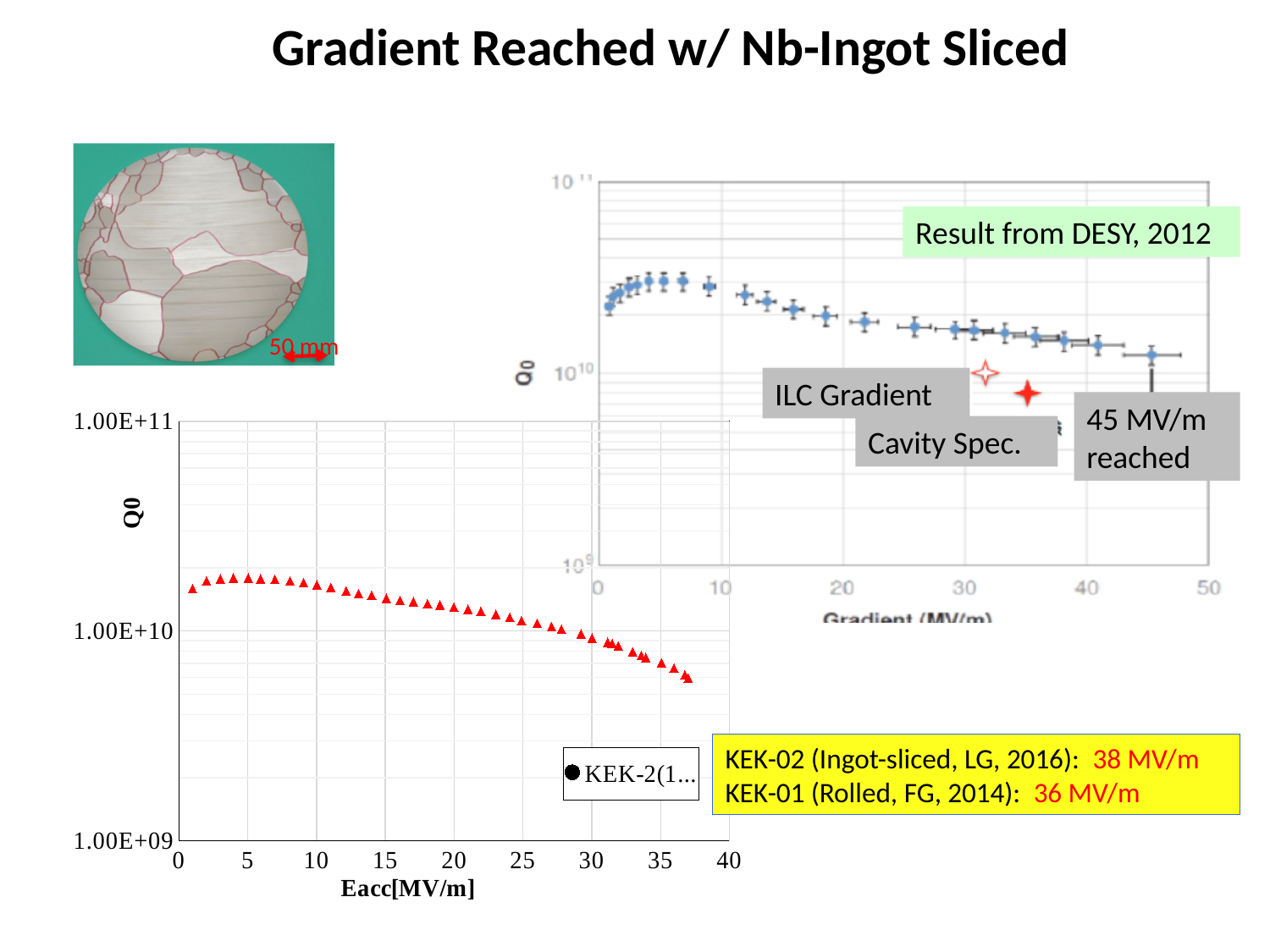
How many series does the legend of the bottom-left chart list? 1 In the top-right chart labelled 'Result from DESY, 2012', is the Q0 value at a gradient of 5 MV/m greater or less than 10^10? greater In the bottom-left chart, which has the larger Q0: the point at Eacc = 5 MV/m or the point at Eacc = 35 MV/m? Eacc = 5 MV/m What is the label of the x axis of the bottom-left chart? Eacc[MV/m] In the bottom-left chart, is the Q0 value at Eacc = 35 MV/m greater or less than 1.00E+10? less In the top-right chart labelled 'Result from DESY, 2012', which has the larger Q0: the point at a gradient of 5 MV/m or the point at 45 MV/m? 5 MV/m In the bottom-left chart, does Q0 rise or fall as Eacc increases from 10 to 35 MV/m? fall In the bottom-left chart, is the Q0 value at Eacc = 5 MV/m greater or less than 1.00E+10? greater What is the highest tick value shown on the x axis of the bottom-left chart? 40 In the top-right chart labelled 'Result from DESY, 2012', does Q0 rise or fall as the gradient increases from 10 to 45 MV/m? fall What kind of chart is the bottom-left chart with the Eacc[MV/m] axis? scatter chart